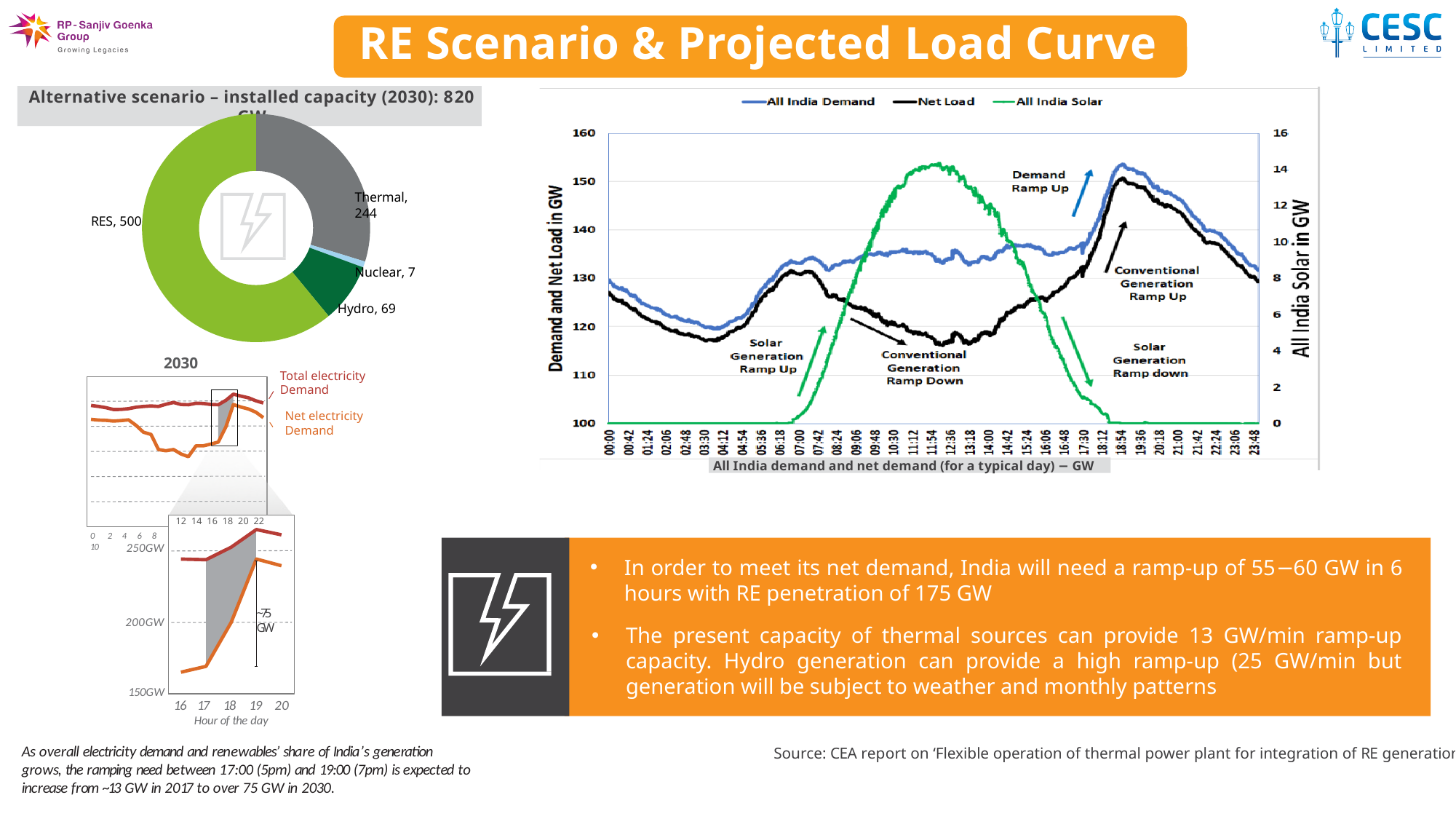
In the chart 'All India demand and net demand (for a typical day) – GW', is the peak value of All India Solar greater or less than 12 on the right axis? greater In the donut chart 'Alternative scenario – installed capacity (2030)', what is the value for RES? 500 How many series does the legend list in the chart 'All India demand and net demand (for a typical day) – GW'? 3 In the donut chart 'Alternative scenario – installed capacity (2030)', what is the difference between the RES and Thermal values? 256 In the donut chart 'Alternative scenario – installed capacity (2030)', what is the value for Hydro? 69 In the donut chart 'Alternative scenario – installed capacity (2030)', which category has the smallest value? Nuclear How many categories are shown in the donut chart 'Alternative scenario – installed capacity (2030)'? 4 In the donut chart 'Alternative scenario – installed capacity (2030)', what is the value for Thermal? 244 In the donut chart 'Alternative scenario – installed capacity (2030)', what is the total of all the categories? 820 In the chart 'All India demand and net demand (for a typical day) – GW', does the All India Solar series rise or fall between 06:18 and 11:54? rise What type of chart is 'All India demand and net demand (for a typical day) – GW'? Line chart In the donut chart 'Alternative scenario – installed capacity (2030)', which category has the largest value? RES